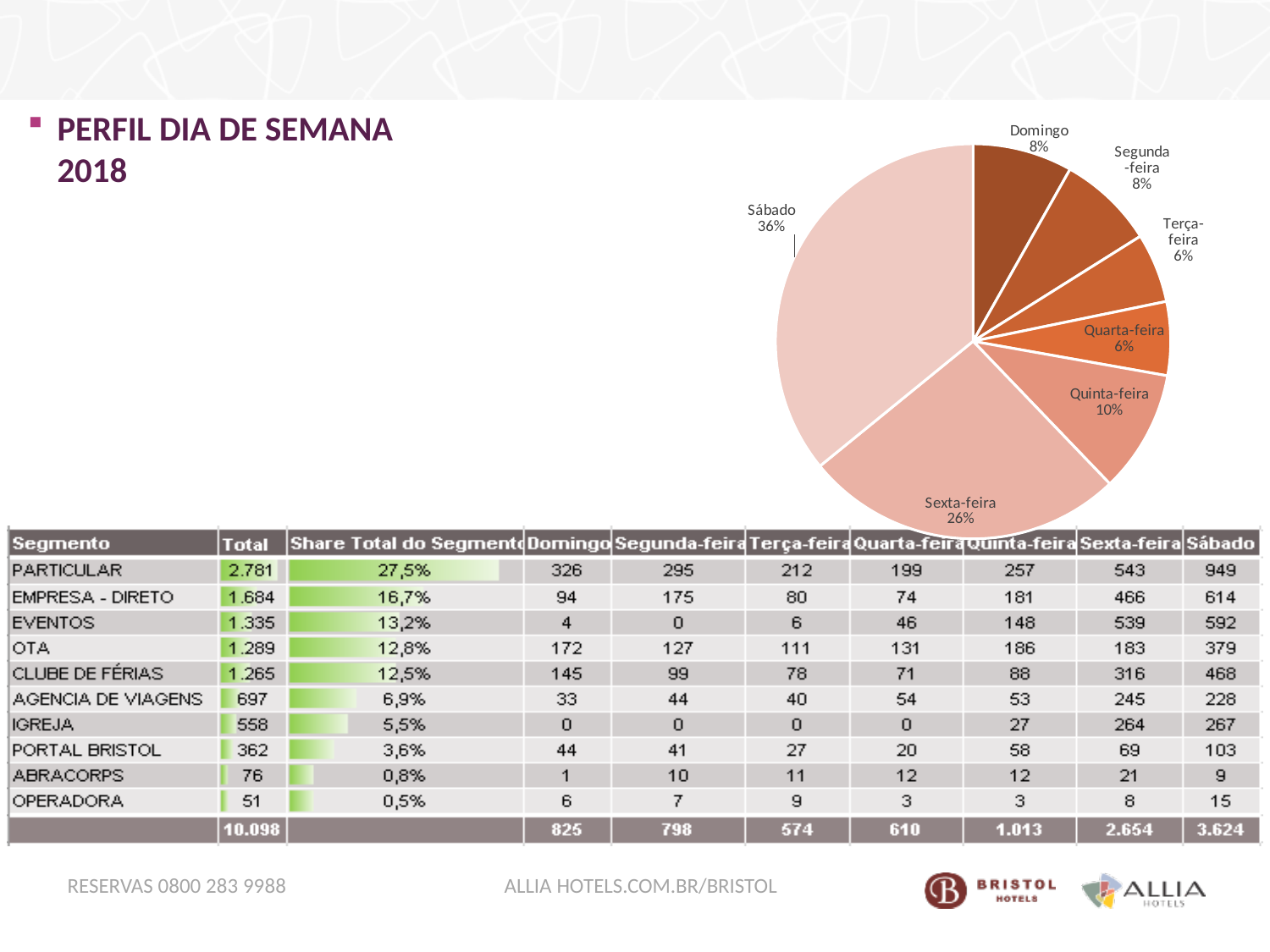
Which is larger in the pie chart, Quinta-feira or Quarta-feira? Quinta-feira What is the difference in percentage points between Sábado and Sexta-feira in the pie chart? 10 What is the value shown for Quinta-feira in the pie chart? 10% What is the value shown for Domingo in the pie chart? 8% What is the difference in percentage points between Quinta-feira and Terça-feira in the pie chart? 4 What is the value shown for Segunda-feira in the pie chart? 8% What share of the pie chart does Sexta-feira represent? 26% What is the title of the slide containing the pie chart? PERFIL DIA DE SEMANA 2018 Which day has the largest slice in the pie chart? Sábado How many slices does the pie chart have? 7 What share of the pie chart does Sábado represent? 36% What type of chart is shown on the slide? pie chart